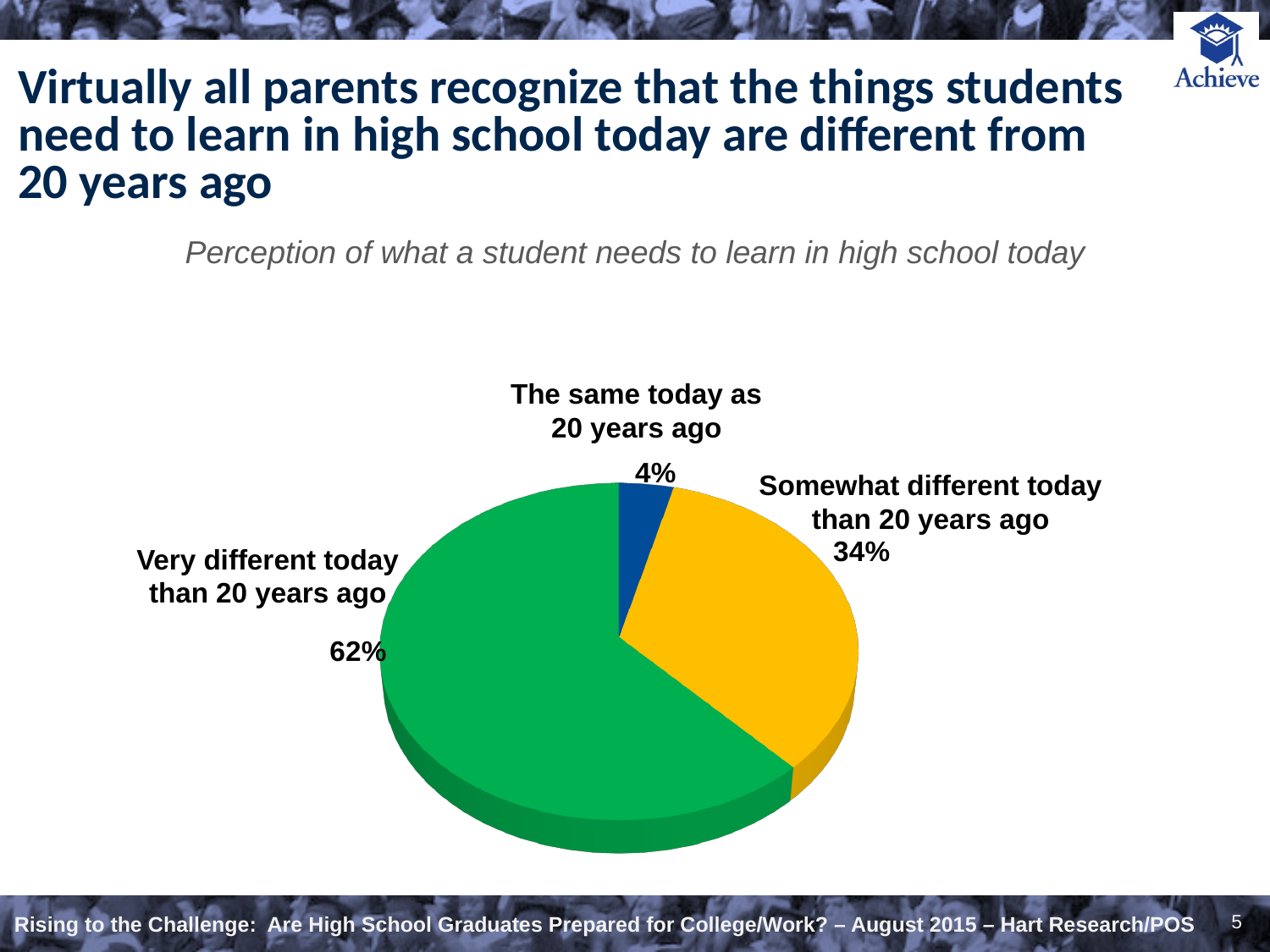
What is the difference in percentage points between 'Very different today than 20 years ago' and 'Somewhat different today than 20 years ago'? 28 What colour is the slice for 'Very different today than 20 years ago'? Green Which response has the smallest share of the pie? The same today as 20 years ago What percentage of parents say what students need to learn is very different today than 20 years ago? 62% What percentage of parents say what students need to learn is somewhat different today than 20 years ago? 34% What percentage of parents say what students need to learn is the same today as 20 years ago? 4% What is the combined share of parents who say what students need to learn is very or somewhat different today than 20 years ago? 96% Which response has the largest share of the pie? Very different today than 20 years ago How many slices does the pie chart have? 3 Which is larger: the share for 'Somewhat different today than 20 years ago' or 'The same today as 20 years ago'? Somewhat different today than 20 years ago What is the difference in percentage points between 'Somewhat different today than 20 years ago' and 'The same today as 20 years ago'? 30 What kind of chart is shown on the slide? Pie chart